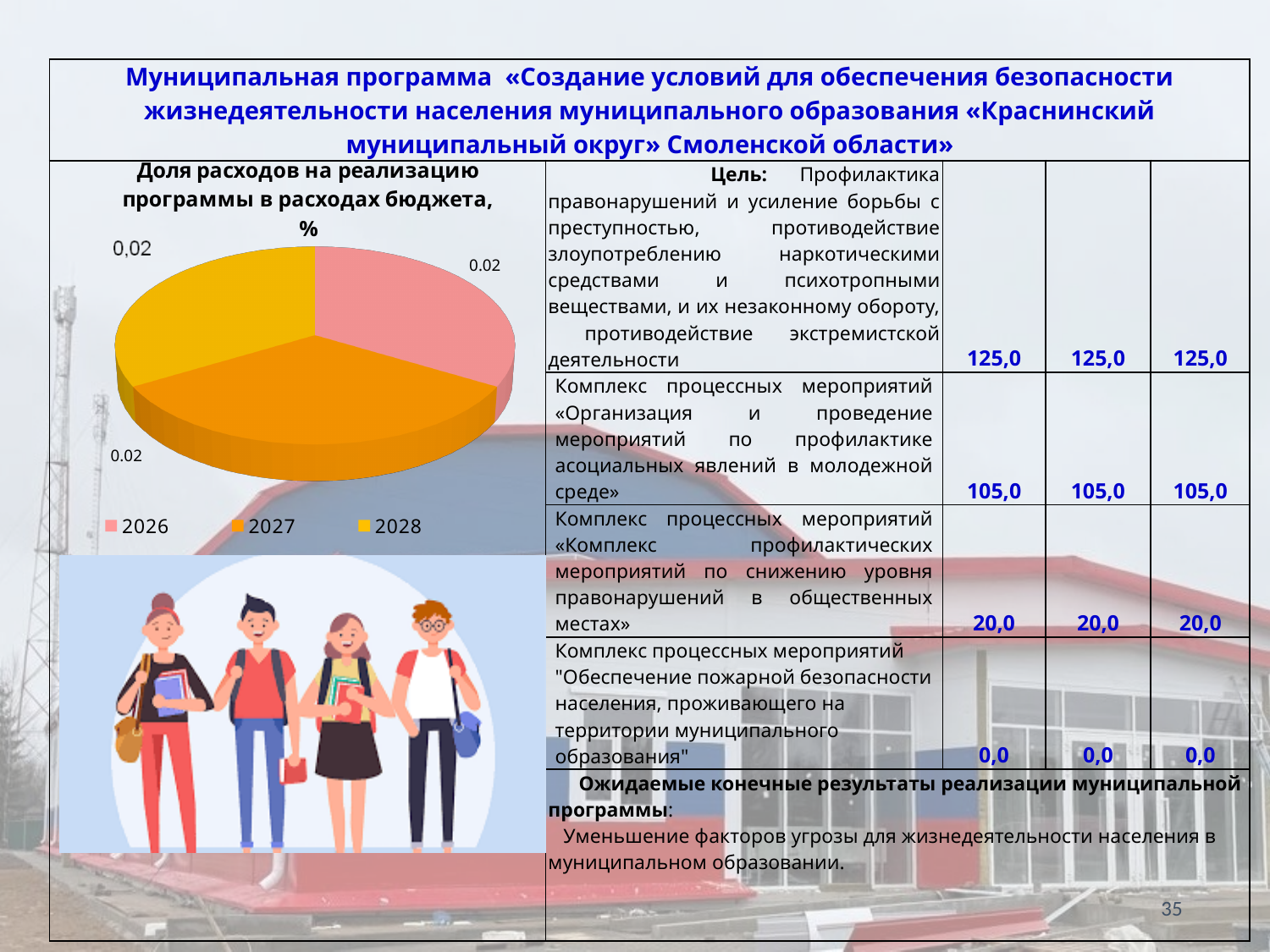
What kind of chart is shown on the slide? pie chart What value is shown for 2027 in the pie chart? 0.02 What is the title of the pie chart? Доля расходов на реализацию программы в расходах бюджета, % How many entries does the legend of the pie chart list? 3 What value is shown for 2026 in the pie chart? 0.02 What value is shown for 2028 in the pie chart? 0,02 How many slices does the pie chart have? 3 Which years are listed in the legend of the pie chart? 2026, 2027, 2028